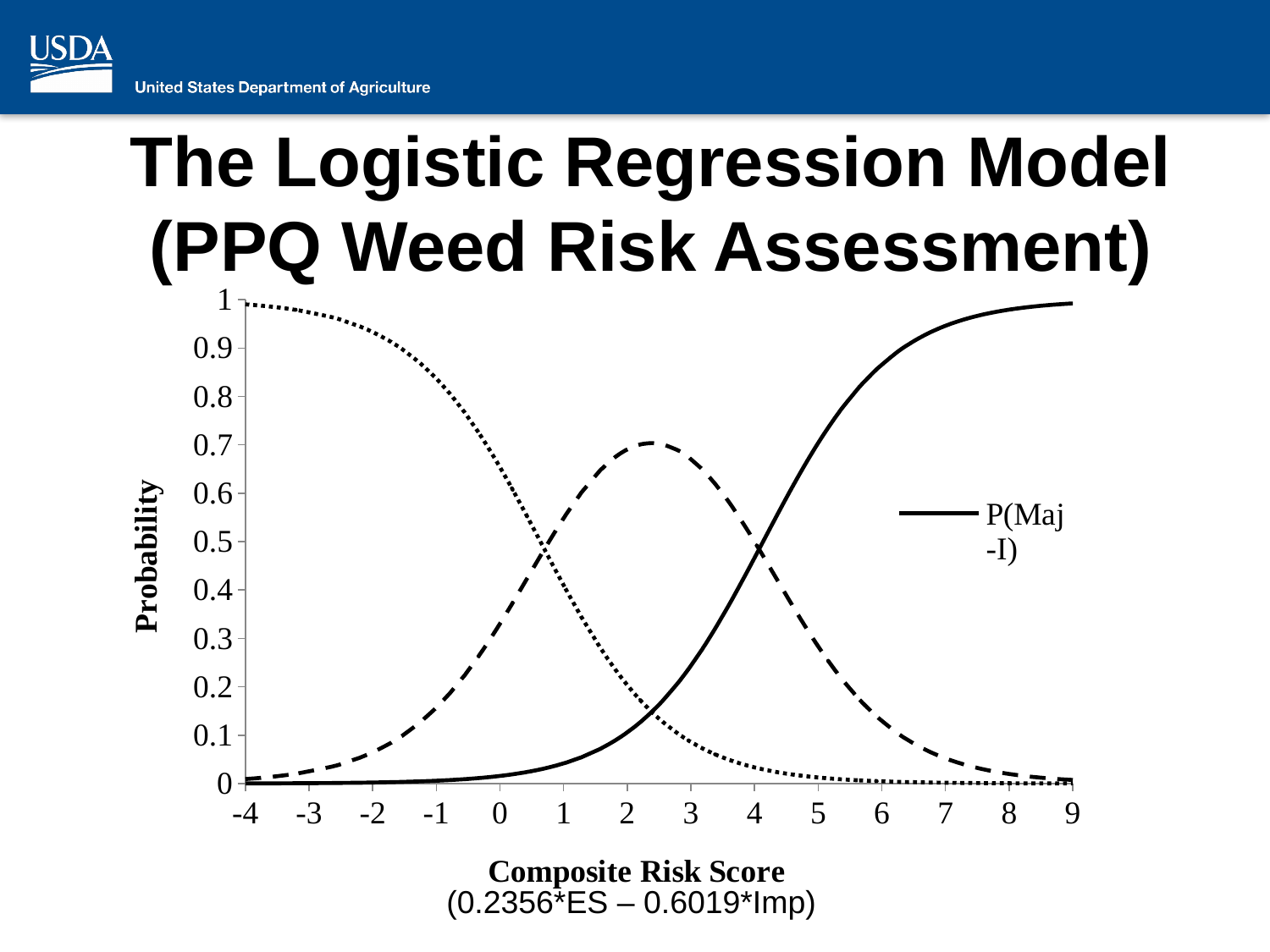
Is the peak value of the dashed line greater or less than 0.6? greater How many series does the chart's legend list? 1 Is the value of the solid P(Maj-I) line at a Composite Risk Score of 0 greater or less than 0.1? less What is the title of the chart's x axis? Composite Risk Score Does the dotted line rise or fall as the Composite Risk Score increases? fall How many curves are plotted on the chart? 3 Is the value of the solid P(Maj-I) line at a Composite Risk Score of 9 greater or less than 0.9? greater What is the title of the chart's y axis? Probability At a Composite Risk Score of 9, which is larger: the solid P(Maj-I) line or the dotted line? the solid P(Maj-I) line Does the solid P(Maj-I) line rise or fall as the Composite Risk Score increases? rise What kind of chart is shown on the slide? line chart